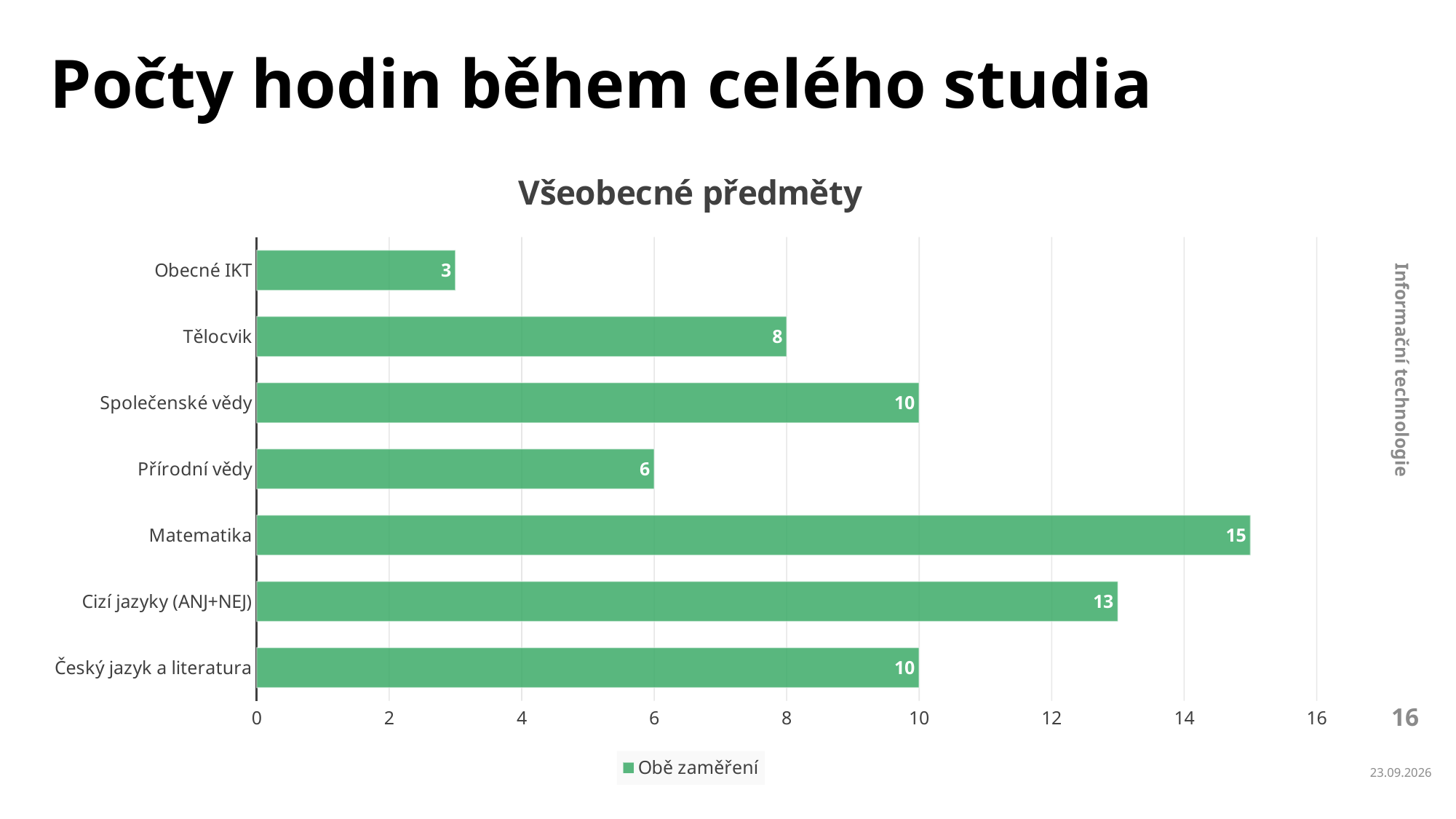
How many categories are shown in the chart? 7 What is the value for Obecné IKT? 3 What kind of chart is shown on the slide? bar chart Is the value for Cizí jazyky (ANJ+NEJ) greater or less than 10? greater How many series does the legend list? 1 What is the value for Cizí jazyky (ANJ+NEJ)? 13 What is the title of the chart? Všeobecné předměty Which category has the highest value? Matematika Which is larger, the value for Přírodní vědy or the value for Tělocvik? Tělocvik What is the value for Matematika? 15 What is the difference between the values for Matematika and Tělocvik? 7 Which category has the lowest value? Obecné IKT